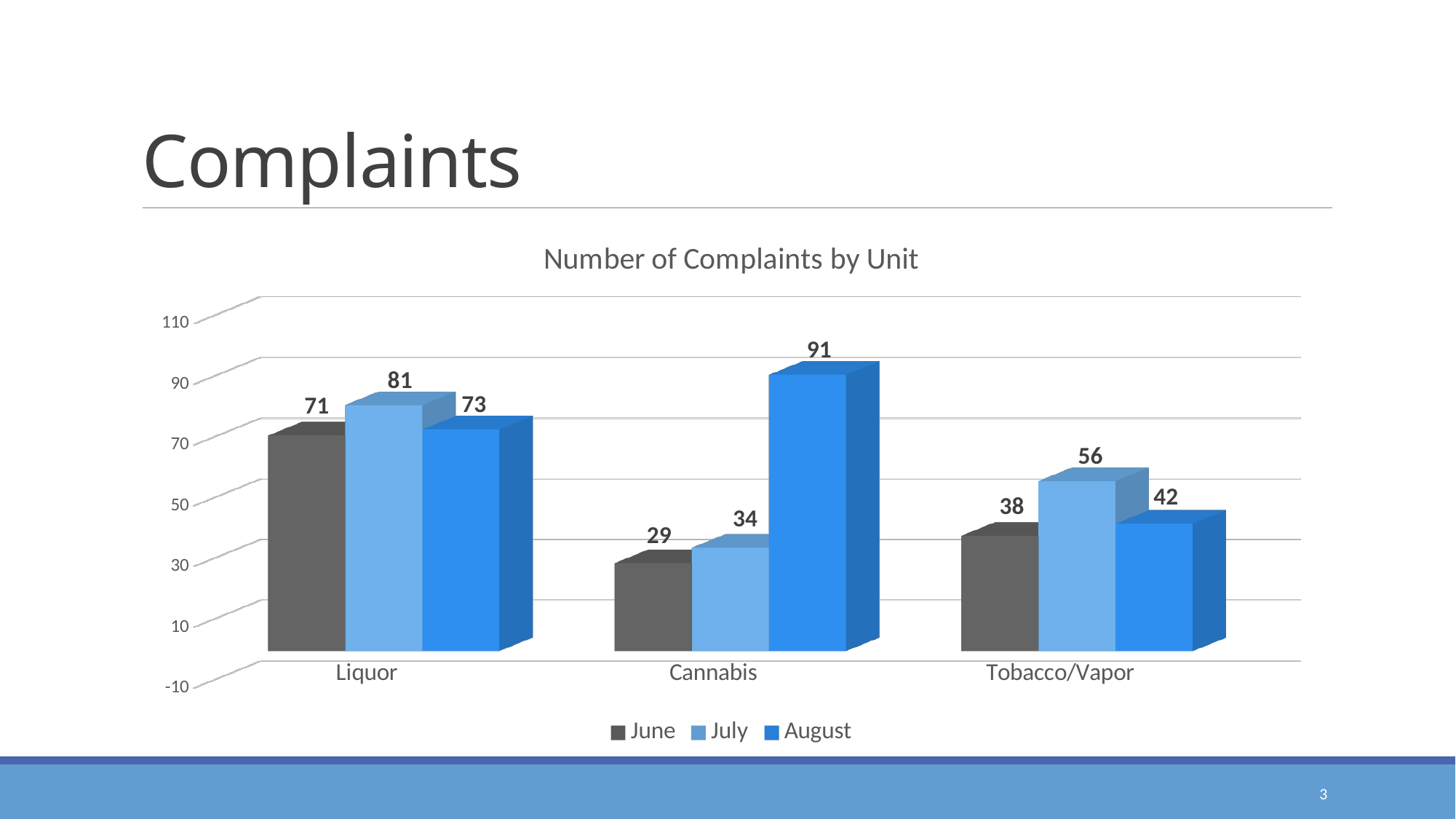
How many series does the legend list? 3 What is the total number of complaints for the Liquor unit across June, July and August? 225 How many units are shown on the x axis of the chart? 3 What is the title of the chart? Number of Complaints by Unit Which unit has the lowest number of complaints in June? Cannabis What is the number of complaints for the Cannabis unit in August? 91 What is the number of complaints for the Liquor unit in July? 81 Which is larger for the Tobacco/Vapor unit: the July value or the August value? July What is the number of complaints for the Tobacco/Vapor unit in June? 38 Which unit has the highest number of complaints in August? Cannabis What kind of chart is shown on the slide? Bar chart What is the difference between the August and June complaints for the Cannabis unit? 62